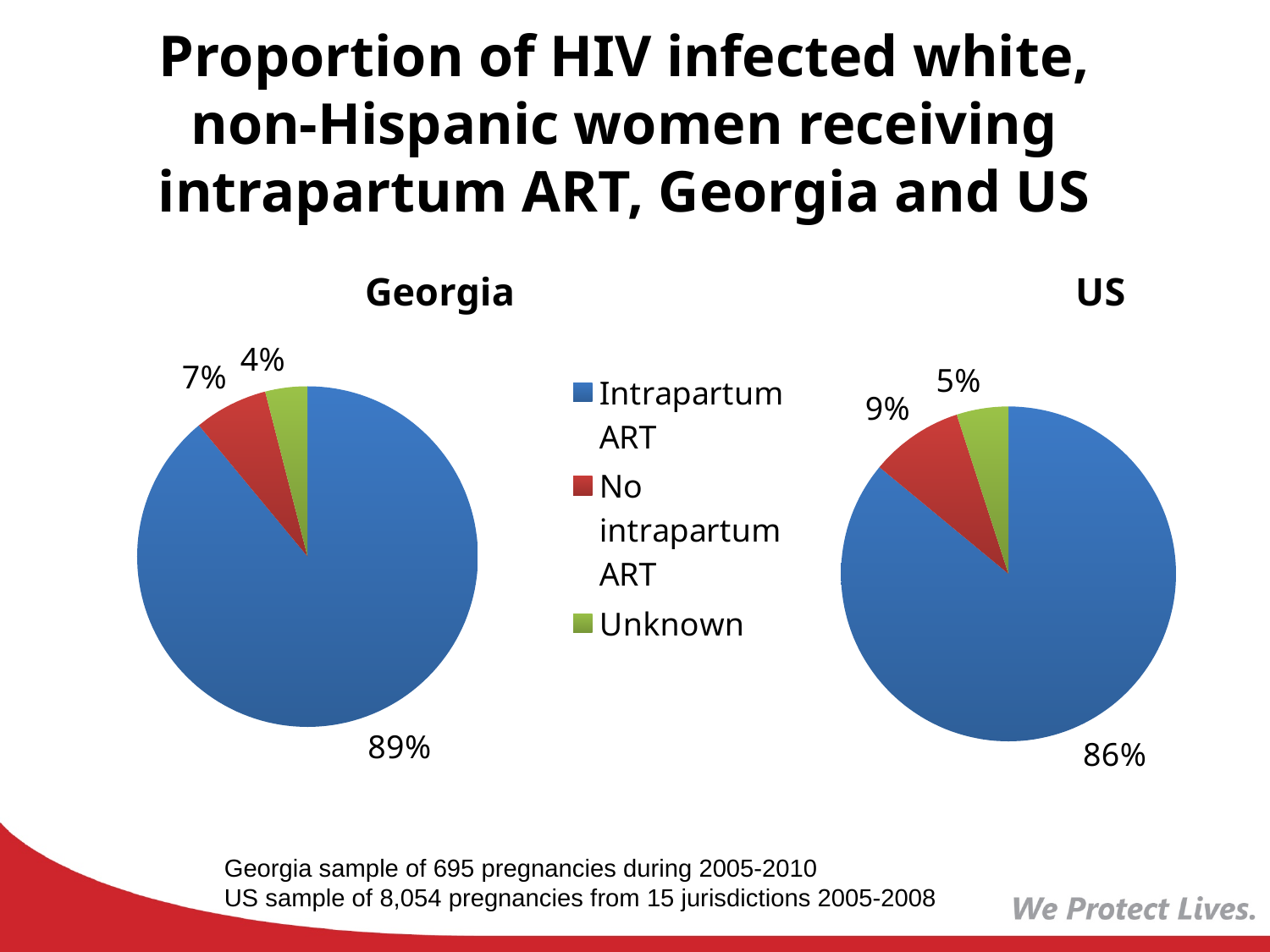
What colour represents 'Unknown' in the pie charts? Green What is the difference between the 'Intrapartum ART' share in Georgia and in the US? 3% Which is larger: the 'No intrapartum ART' share in Georgia or in the US? US In the US pie chart, what percentage of women received intrapartum ART? 86% In the US pie chart, what is the difference between the 'No intrapartum ART' and 'Unknown' shares? 4% In the Georgia pie chart, what is the share for 'No intrapartum ART'? 7% In the US pie chart, what is the share for 'Unknown'? 5% In the Georgia pie chart, what percentage of women received intrapartum ART? 89% What type of chart is used on this slide? Pie chart In the US pie chart, which category has the largest slice? Intrapartum ART How many categories does the legend list? 3 In the Georgia pie chart, which category has the smallest slice? Unknown